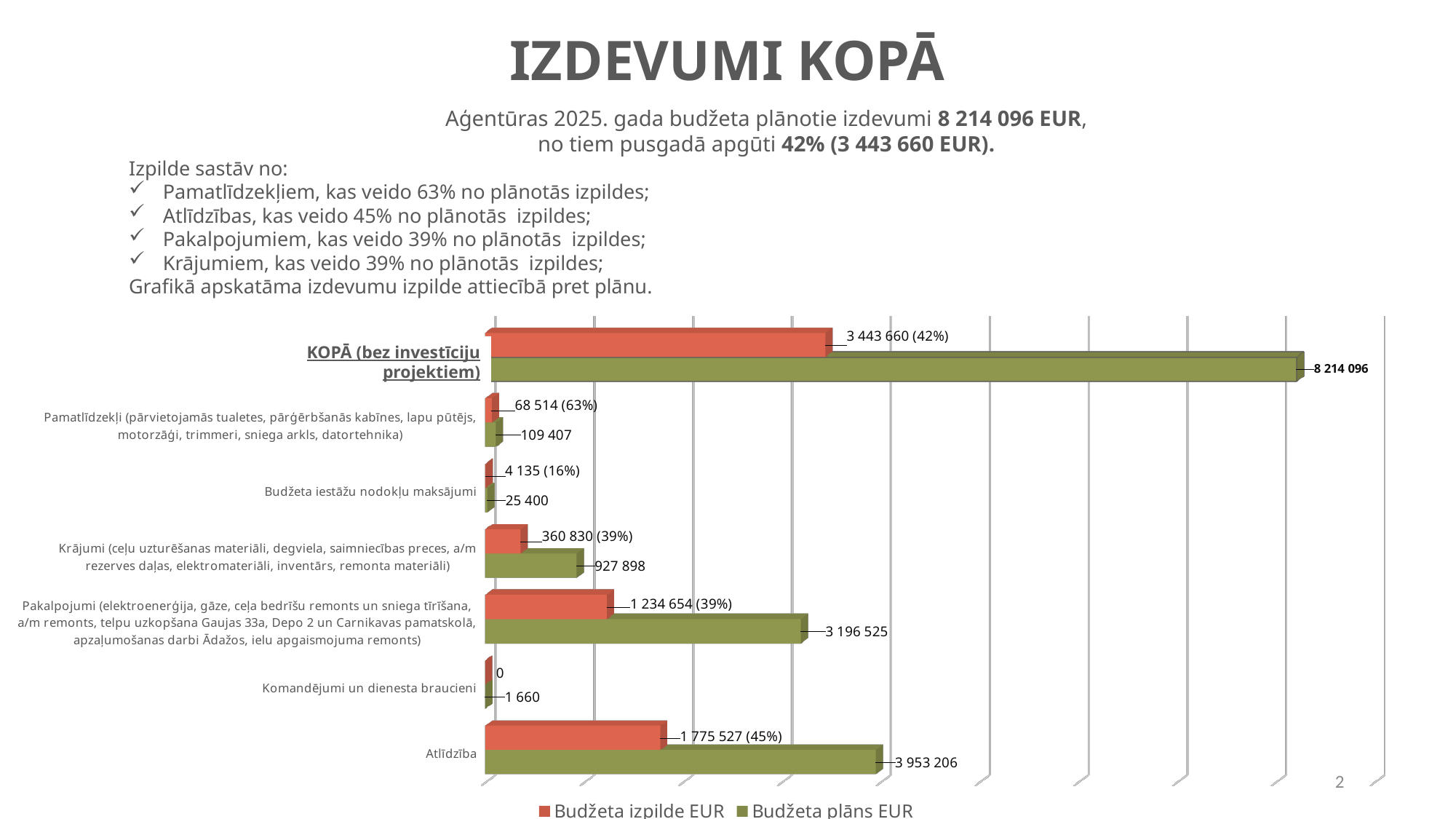
Which is larger: the Budžeta izpilde EUR value for Atlīdzība or for Pakalpojumi? Atlīdzība What kind of chart is shown on the slide? Bar chart Which category has the highest Budžeta plāns EUR value? KOPĀ (bez investīciju projektiem) Which category has the lowest Budžeta plāns EUR value? Komandējumi un dienesta braucieni What is the Budžeta plāns EUR value for Krājumi? 927 898 How many series does the chart legend list? 2 What is the Budžeta izpilde EUR value for Komandējumi un dienesta braucieni? 0 Which series is shown in red on the chart? Budžeta izpilde EUR What is the difference between the Budžeta plāns EUR and Budžeta izpilde EUR values for Pamatlīdzekļi? 40 893 What is the Budžeta plāns EUR value for Atlīdzība? 3 953 206 What is the Budžeta izpilde EUR value for Pakalpojumi? 1 234 654 How many categories are shown on the chart? 7